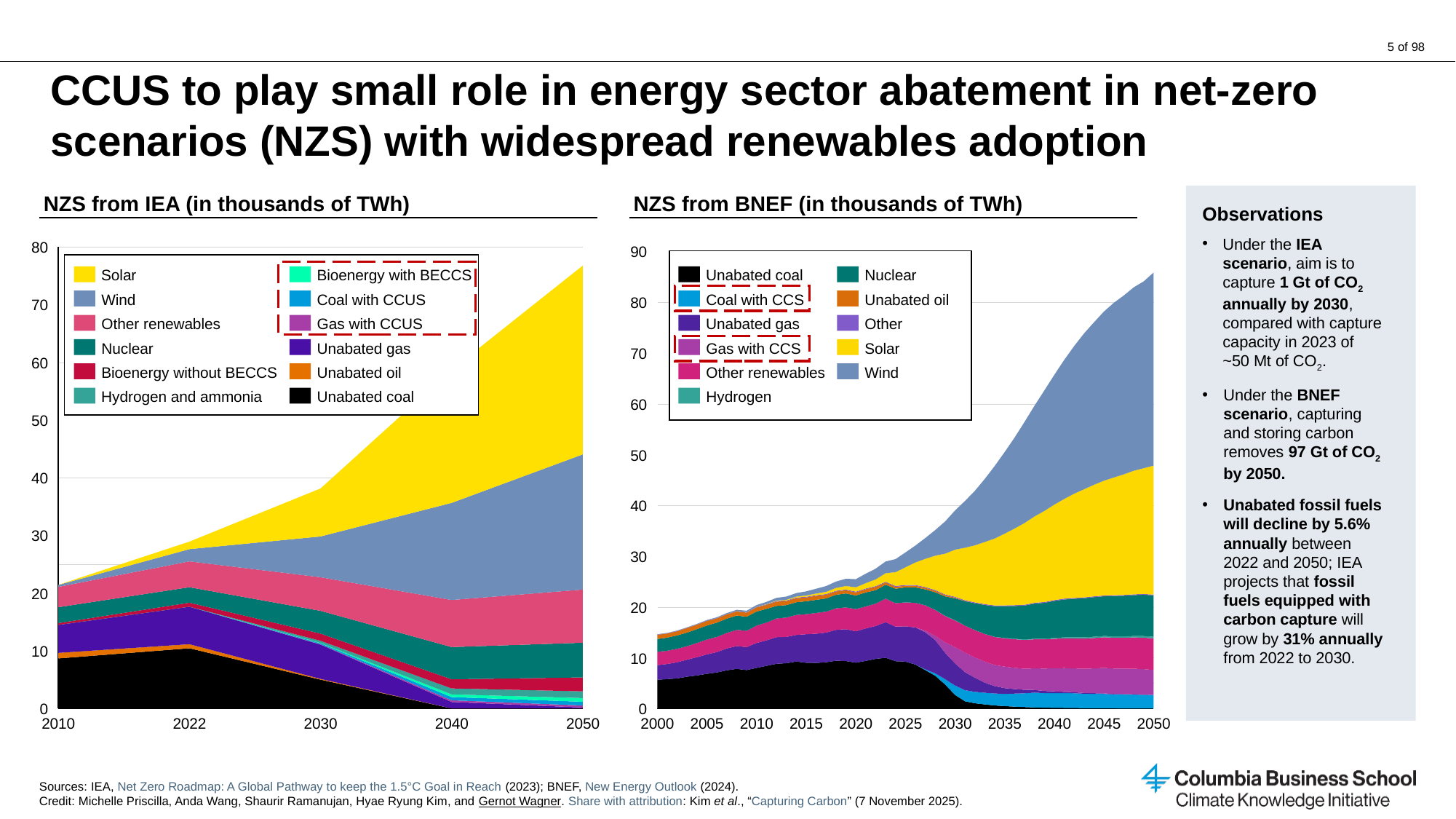
How many year labels are shown on the x axis of the 'NZS from BNEF (in thousands of TWh)' chart? 11 In the 'NZS from IEA (in thousands of TWh)' chart, does the Unabated coal area rise or fall from 2022 to 2050? fall Which series is at the top of the stack in the 'NZS from BNEF (in thousands of TWh)' chart in 2050? Wind In the 'NZS from IEA (in thousands of TWh)' chart, does the total stacked value rise or fall from 2010 to 2050? rise In the 'NZS from BNEF (in thousands of TWh)' chart, is the total stacked value in 2050 greater or less than 80? greater How many series does the legend of the 'NZS from IEA (in thousands of TWh)' chart list? 12 In the 'NZS from BNEF (in thousands of TWh)' chart, is the total stacked value in 2000 greater or less than 20? less What kind of chart is the 'NZS from IEA (in thousands of TWh)' chart? stacked area chart What colour represents Solar in the 'NZS from IEA (in thousands of TWh)' chart? yellow In the 'NZS from IEA (in thousands of TWh)' chart, is the total stacked value in 2050 greater or less than 70? greater How many series does the legend of the 'NZS from BNEF (in thousands of TWh)' chart list? 11 How many year labels are shown on the x axis of the 'NZS from IEA (in thousands of TWh)' chart? 5